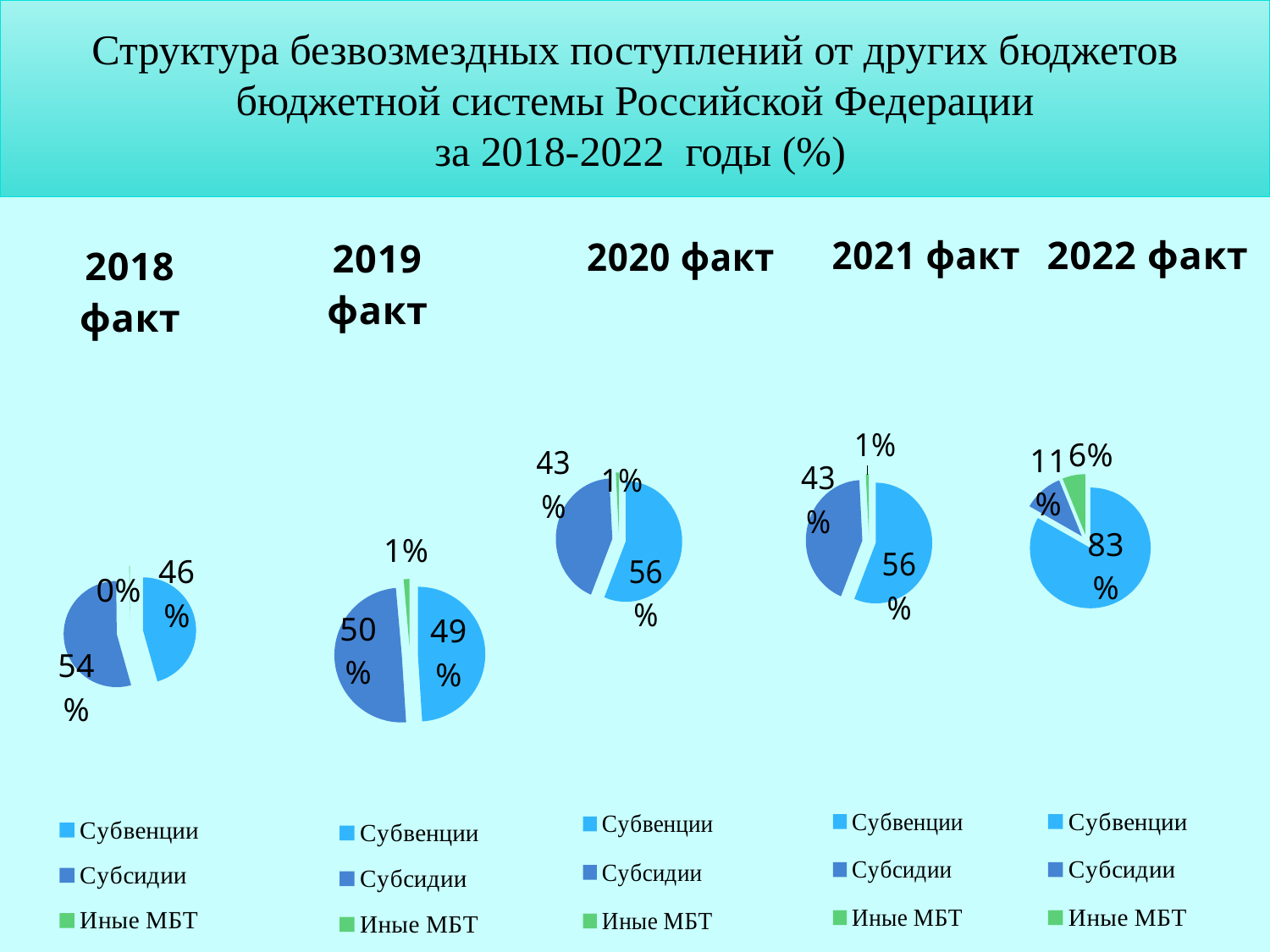
In the 2018 факт pie chart, what is the share for Субсидии? 54% How many entries does the legend of the 2020 факт chart list? 3 In the 2018 факт pie chart, which category has the smallest slice? Иные МБТ In the 2022 факт pie chart, what is the share for Субсидии? 11% In the 2020 факт pie chart, what is the share for Субвенции? 56% What type of chart is used for 2019 факт? Pie chart In the 2019 факт pie chart, what is the share for Иные МБТ? 1% In the 2018 факт pie chart, what is the share for Субвенции? 46% How many pie charts are shown on the slide? 5 In the 2022 факт pie chart, which category has the largest slice? Субвенции In the 2022 факт pie chart, what is the difference in percentage points between Субвенции and Субсидии? 72 In the 2021 факт pie chart, which is larger, Субвенции or Субсидии? Субвенции